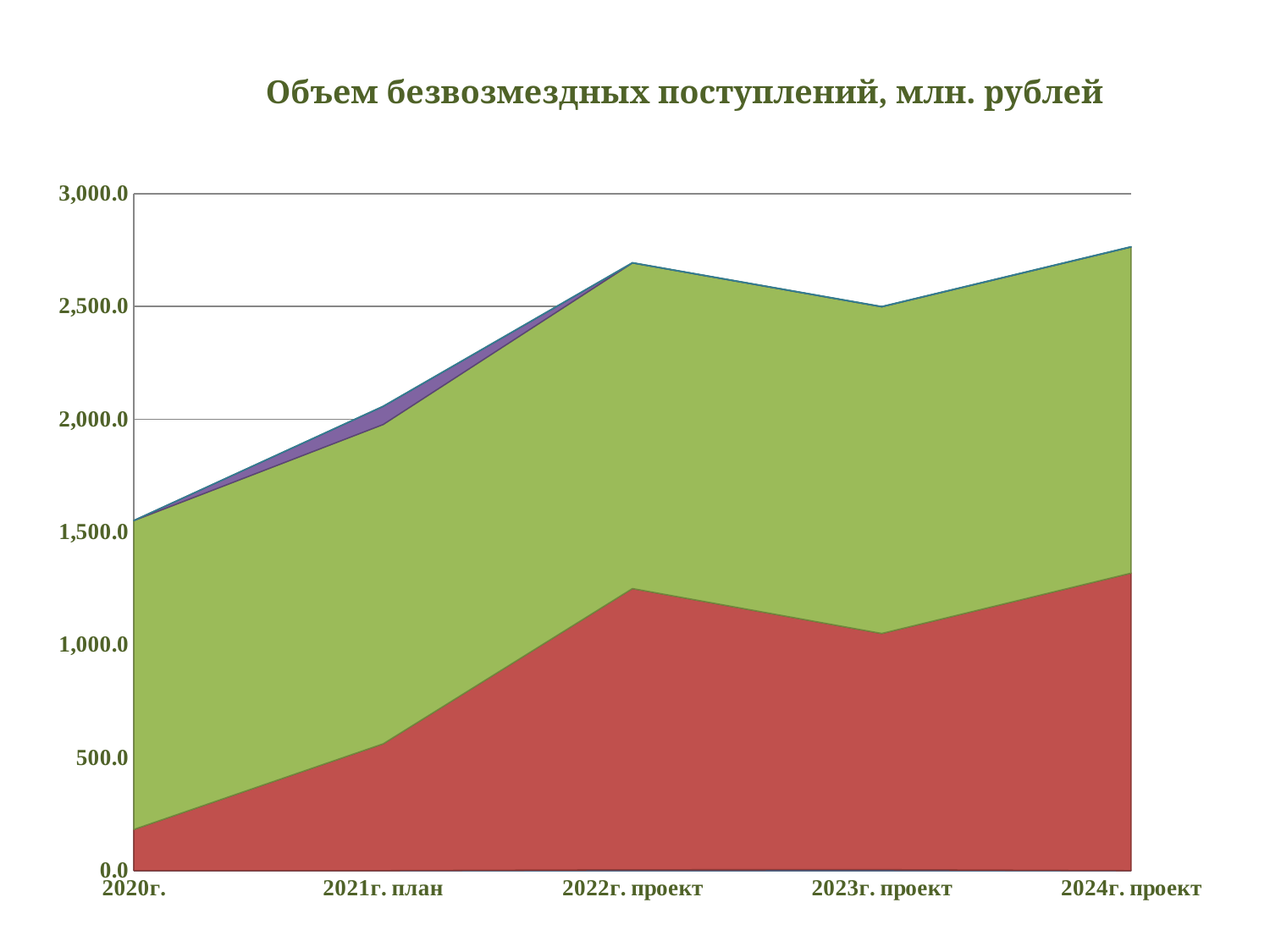
Is the total stacked value for 2022г. проект greater or less than 2,500.0? greater Is the value of the bottom (red) series for 2024г. проект greater or less than 1,000.0? greater What kind of chart is shown on the slide? area chart Is the total stacked value for 2023г. проект greater or less than 3,000.0? less What is the title of the chart? Объем безвозмездных поступлений, млн. рублей Which category has the lowest total stacked value? 2020г. Does the total stacked value rise or fall from 2022г. проект to 2023г. проект? fall How many categories are shown along the x axis? 5 Does the total stacked value rise or fall from 2020г. to 2022г. проект? rise